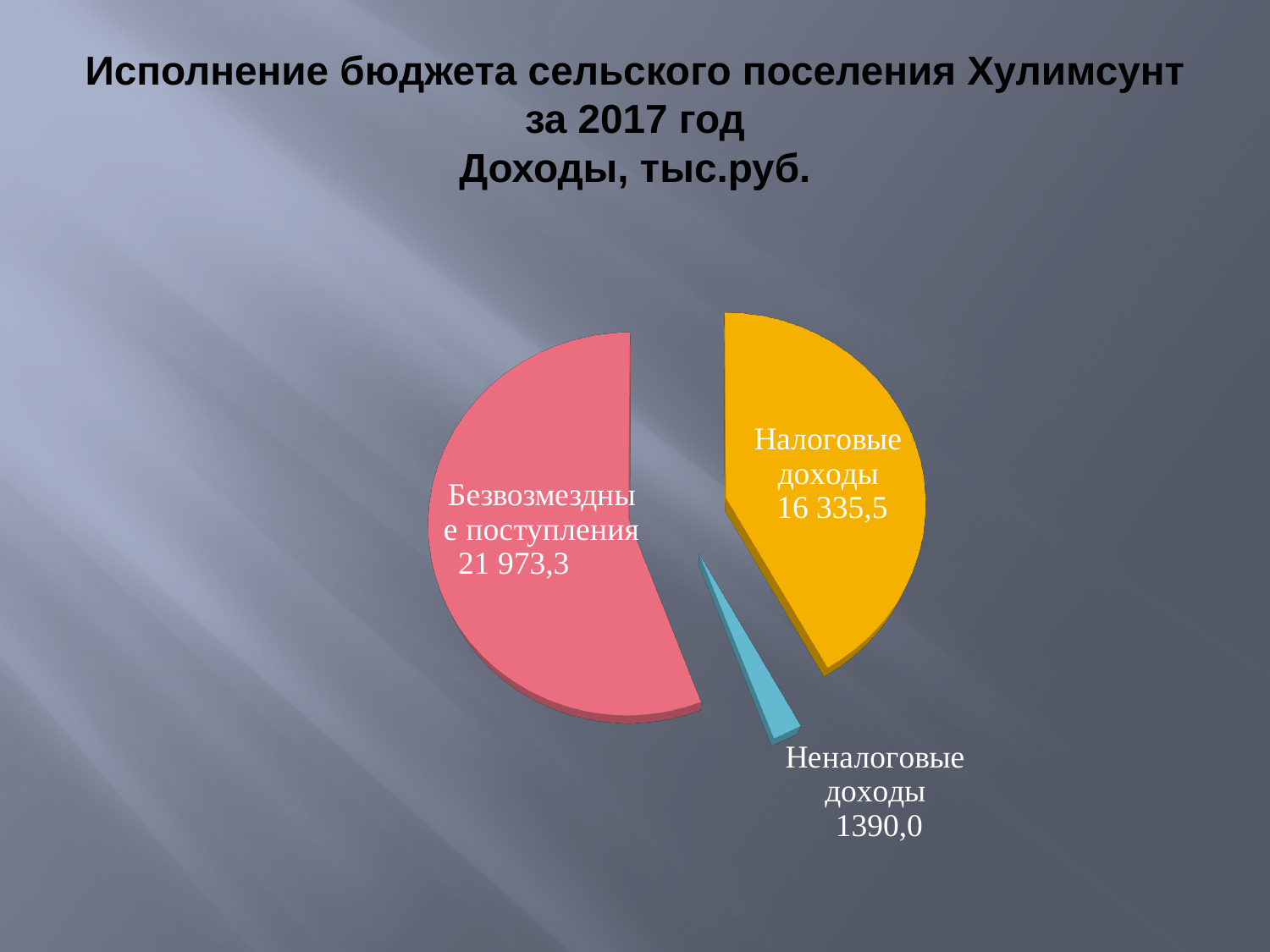
What colour is the slice for Налоговые доходы? yellow What is the total of all three slices of the pie? 39 698,8 What is the value for Безвозмездные поступления? 21 973,3 Which is larger, Налоговые доходы or Неналоговые доходы? Налоговые доходы What type of chart is shown on the slide? pie chart How many slices does the pie chart have? 3 What is the value for Неналоговые доходы? 1390,0 Which category has the smallest slice of the pie? Неналоговые доходы What is the difference between Безвозмездные поступления and Налоговые доходы? 5 637,8 Which category has the largest slice of the pie? Безвозмездные поступления What is the difference between Налоговые доходы and Неналоговые доходы? 14 945,5 What is the value for Налоговые доходы? 16 335,5